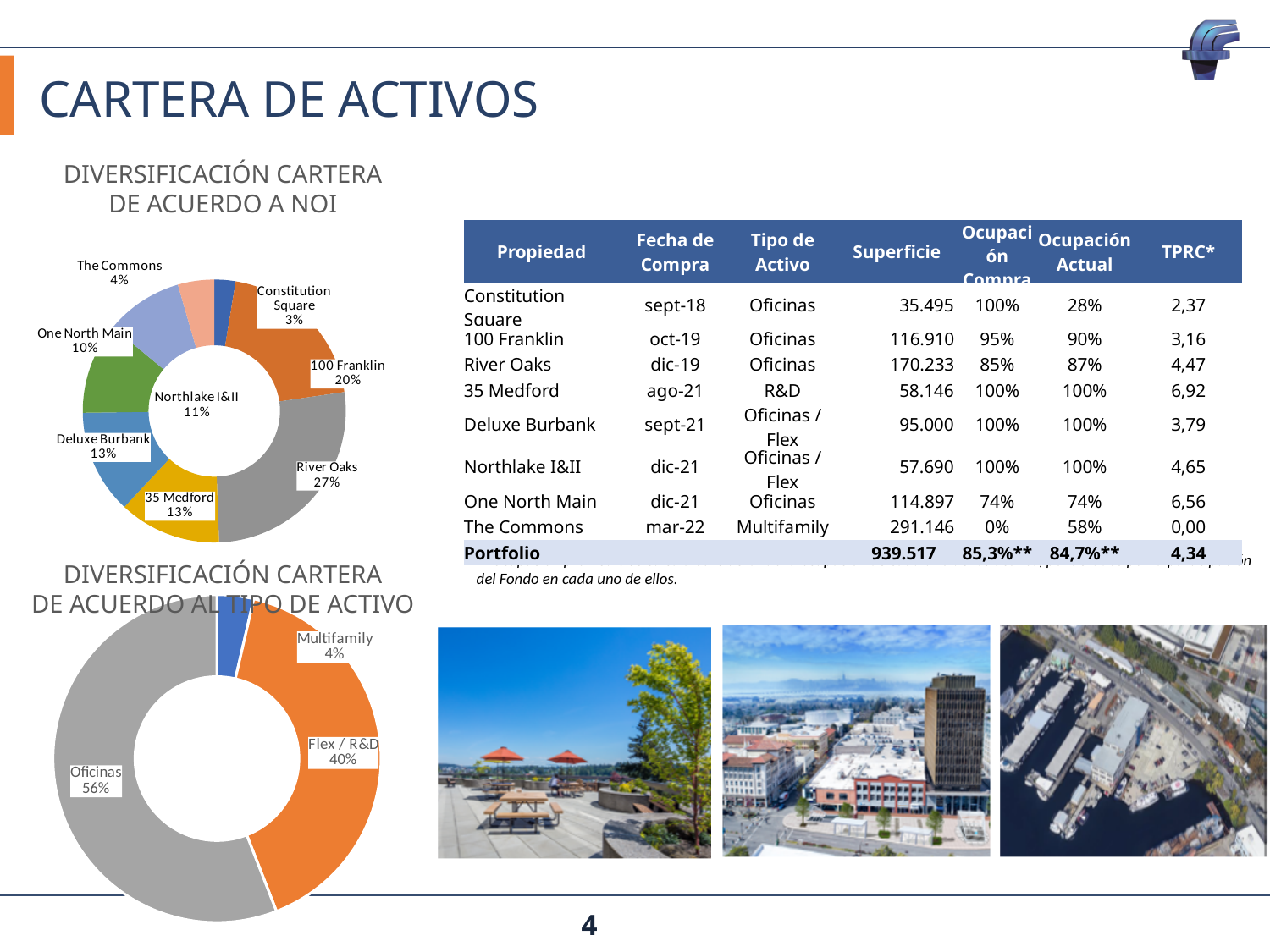
In the 'Diversificación cartera de acuerdo al tipo de activo' chart, which asset type has the smallest share? Multifamily How many categories does the 'Diversificación cartera de acuerdo al tipo de activo' chart show? 3 In the 'Diversificación cartera de acuerdo a NOI' chart, what is the difference between the shares of River Oaks and 100 Franklin? 7 percentage points How many slices does the 'Diversificación cartera de acuerdo a NOI' chart have? 8 In the 'Diversificación cartera de acuerdo al tipo de activo' chart, what share does Flex / R&D have? 40% In the 'Diversificación cartera de acuerdo a NOI' chart, what share does 100 Franklin have? 20% What kind of chart is the 'Diversificación cartera de acuerdo a NOI' chart? Doughnut (pie) chart In the 'Diversificación cartera de acuerdo a NOI' chart, what share does River Oaks have? 27% In the 'Diversificación cartera de acuerdo a NOI' chart, which property has the largest share? River Oaks In the 'Diversificación cartera de acuerdo a NOI' chart, which property has the smallest share? Constitution Square In the 'Diversificación cartera de acuerdo a NOI' chart, which has a larger share, One North Main or Northlake I&II? Northlake I&II In the 'Diversificación cartera de acuerdo al tipo de activo' chart, what share do Oficinas have? 56%